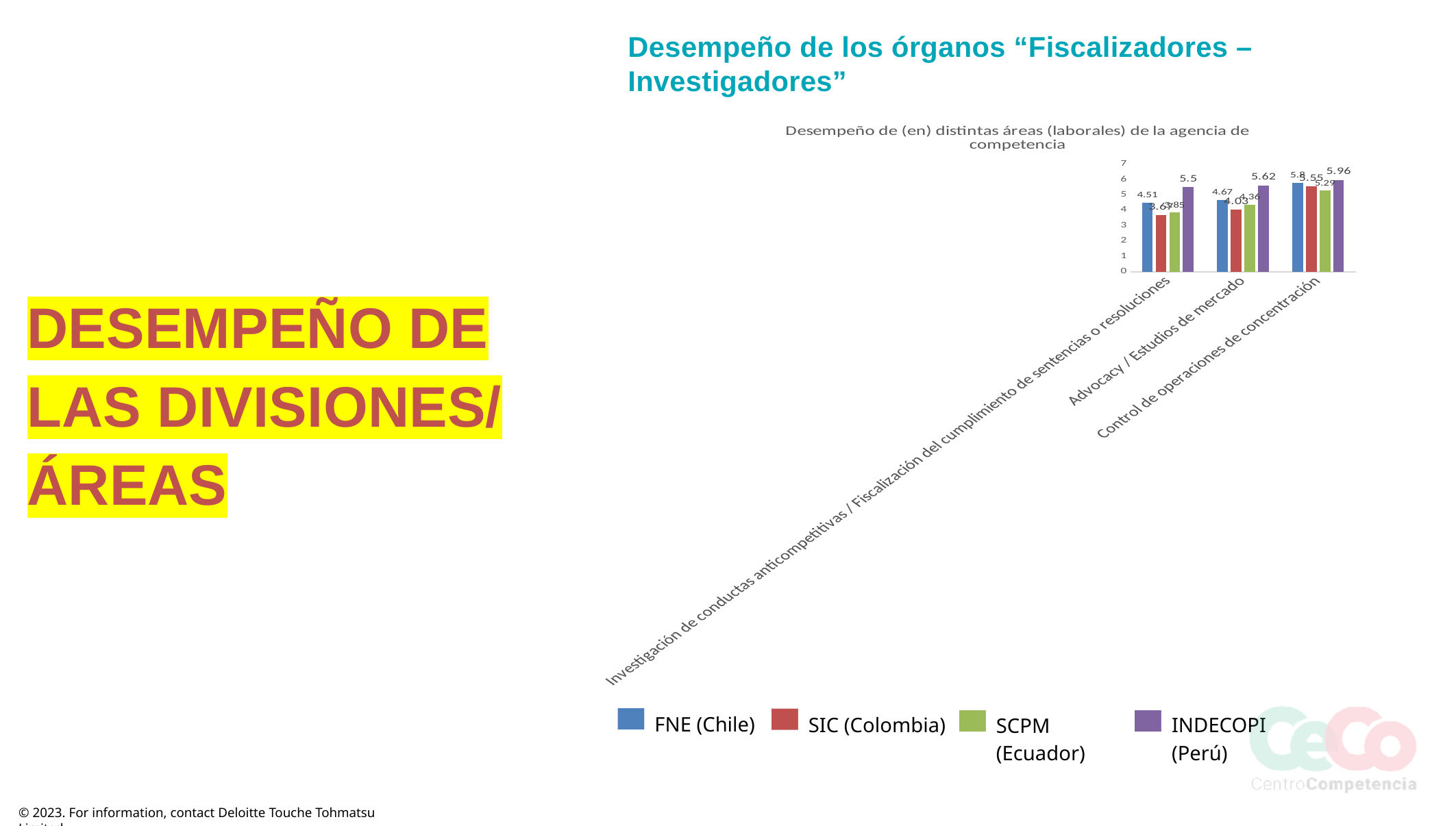
How many series does the chart legend list? 4 What is the difference between INDECOPI (Perú) and FNE (Chile) in the "Advocacy / Estudios de mercado" category? 0.95 What is the value for FNE (Chile) in the "Control de operaciones de concentración" category? 5.8 What is the value for INDECOPI (Perú) in the "Advocacy / Estudios de mercado" category? 5.62 How many categories are shown on the x axis of the chart? 3 Which is larger in the "Control de operaciones de concentración" category: FNE (Chile) or SCPM (Ecuador)? FNE (Chile) Is the value for SIC (Colombia) in the "Investigación de conductas anticompetitivas / Fiscalización del cumplimiento de sentencias o resoluciones" category greater or less than 4? less What is the value for SIC (Colombia) in the "Advocacy / Estudios de mercado" category? 4.03 What type of chart is shown on the slide? Bar chart Which agency has the lowest value in the "Advocacy / Estudios de mercado" category? SIC (Colombia) What is the value for INDECOPI (Perú) in the "Investigación de conductas anticompetitivas / Fiscalización del cumplimiento de sentencias o resoluciones" category? 5.5 Which agency has the highest value in the "Control de operaciones de concentración" category? INDECOPI (Perú)